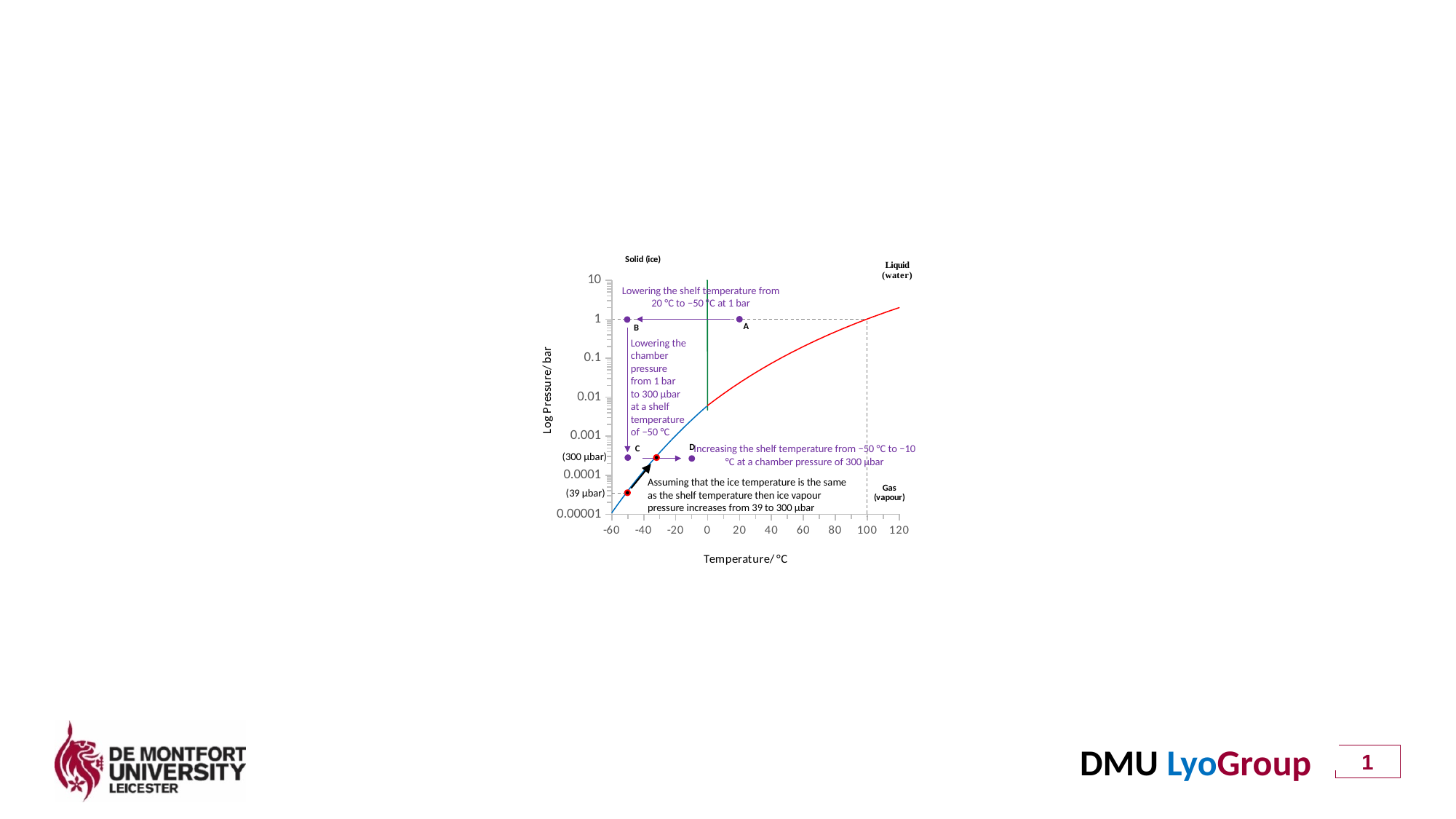
What is the shelf temperature at point B? −50 °C What is the shelf temperature at point A? 20 °C At what pressure are points A and B located? 1 bar Which point has the higher pressure, A or C? A What is the chamber pressure at point C? 300 µbar How many lettered points (A, B, C, D) are marked on the chart? 4 Is the pressure at point C greater or less than 0.001 bar? less Does the phase boundary curve rise or fall as temperature increases? rise What is the ice vapour pressure marked on the y axis below 300 µbar? 39 µbar What is the label of the y axis? Log Pressure/ bar What is the label of the x axis? Temperature/ °C What is the shelf temperature at point D? −10 °C